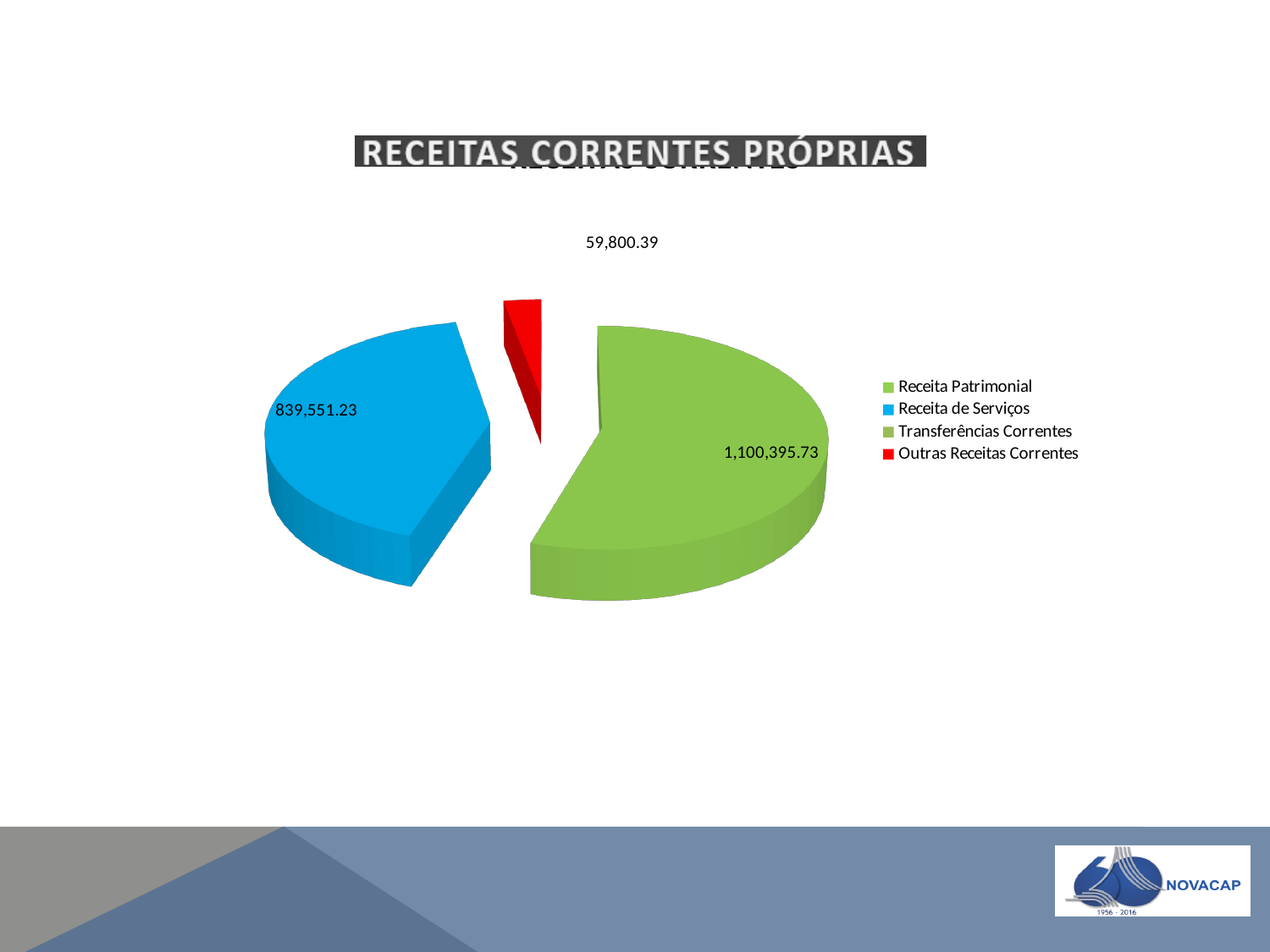
Which category has the largest slice of the pie? Receita Patrimonial What is the value shown for Outras Receitas Correntes? 59,800.39 What colour is the slice for Outras Receitas Correntes? red Which of the slices with a data label is the smallest? Outras Receitas Correntes What is the value shown for Receita Patrimonial? 1,100,395.73 What is the value shown for Receita de Serviços? 839,551.23 What is the difference between the values for Receita de Serviços and Outras Receitas Correntes? 779,750.84 How many slices with data labels are visible in the pie? 3 Which is larger, Receita de Serviços or Outras Receitas Correntes? Receita de Serviços What kind of chart is shown on the slide? pie chart How many entries does the legend list? 4 What is the difference between the values for Receita Patrimonial and Receita de Serviços? 260,844.50